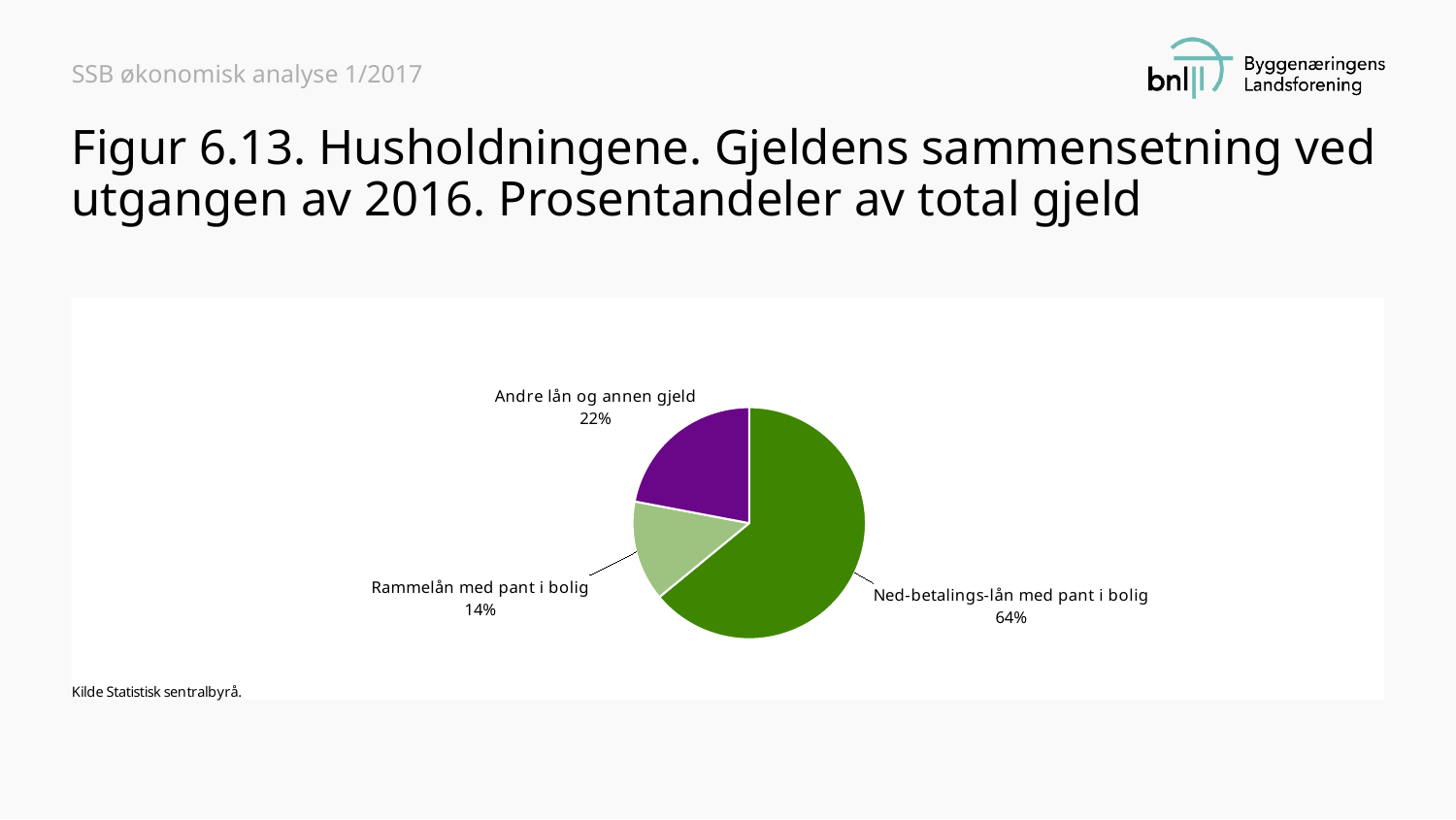
What share of total debt is Rammelån med pant i bolig? 14% What colour is the slice for Andre lån og annen gjeld? purple What is the difference in percentage points between Andre lån og annen gjeld and Rammelån med pant i bolig? 8 What is the source cited below the chart? Statistisk sentralbyrå What is the difference in percentage points between Ned-betalings-lån med pant i bolig and Andre lån og annen gjeld? 42 Which is larger: Andre lån og annen gjeld or Rammelån med pant i bolig? Andre lån og annen gjeld How many slices does the pie chart have? 3 Which category has the largest share of the pie? Ned-betalings-lån med pant i bolig What share of total debt is Ned-betalings-lån med pant i bolig? 64% Which category has the smallest share of the pie? Rammelån med pant i bolig What kind of chart is shown on the slide? pie chart What share of total debt is Andre lån og annen gjeld? 22%